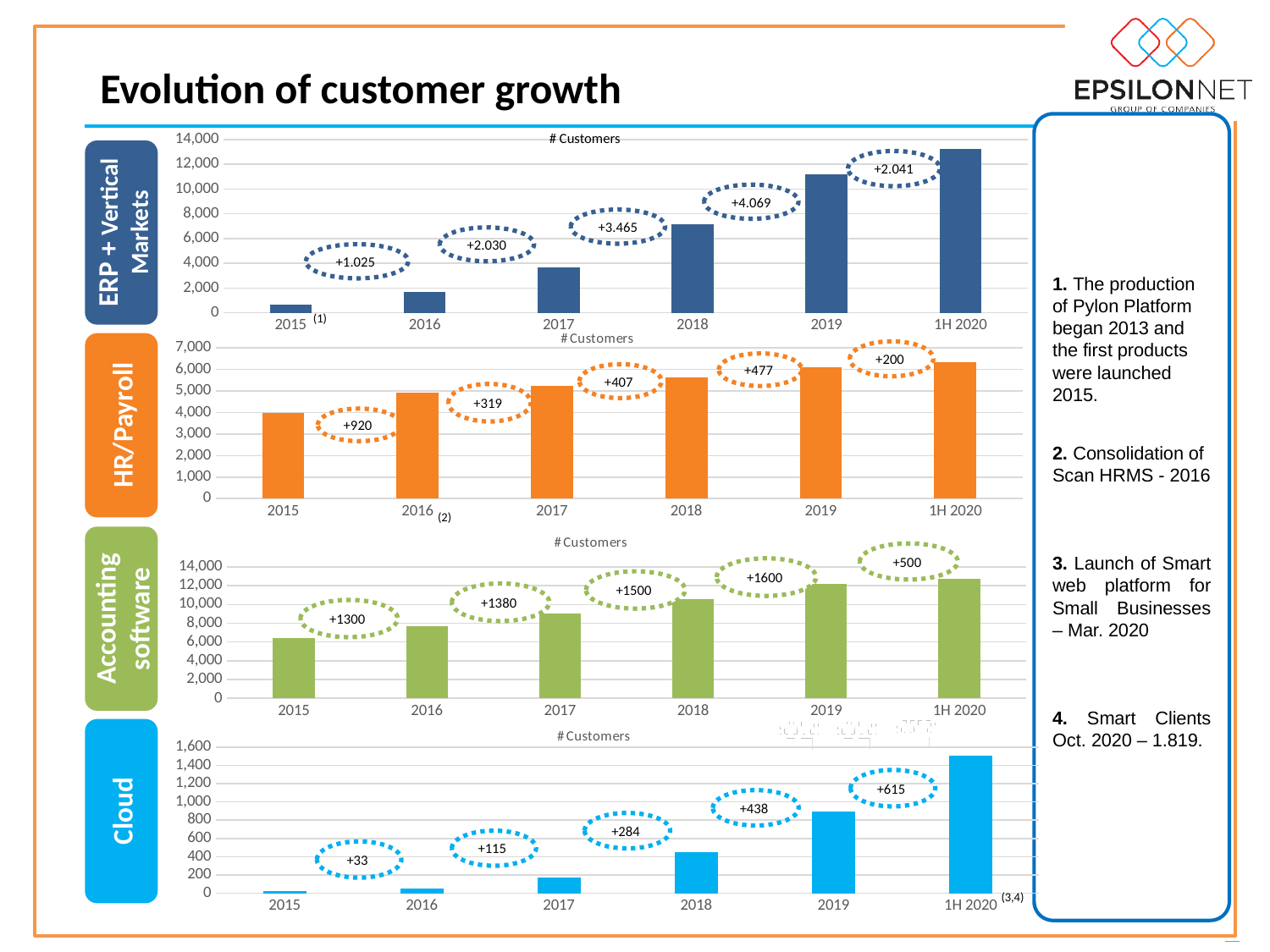
In the HR/Payroll chart, do the values rise or fall from 2015 to 1H 2020? rise In the Cloud chart, is the value for 1H 2020 greater or less than 1,400? greater How many years/periods are shown on the x axis of the Cloud chart? 6 In the ERP + Vertical Markets chart, which period has the highest number of customers? 1H 2020 What is the title of the slide? Evolution of customer growth In the ERP + Vertical Markets chart, is the value for 2019 greater or less than 10,000? greater In the Accounting software chart, is the value for 2018 greater or less than 10,000? greater In the Cloud chart, which period has the lowest number of customers? 2015 What kind of chart is the ERP + Vertical Markets chart? bar chart In the HR/Payroll chart, what growth figure is annotated between 2015 and 2016? +920 In the Accounting software chart, which is larger, the value for 2016 or the value for 2019? 2019 In the ERP + Vertical Markets chart, what growth figure is annotated between 2018 and 2019? +4.069